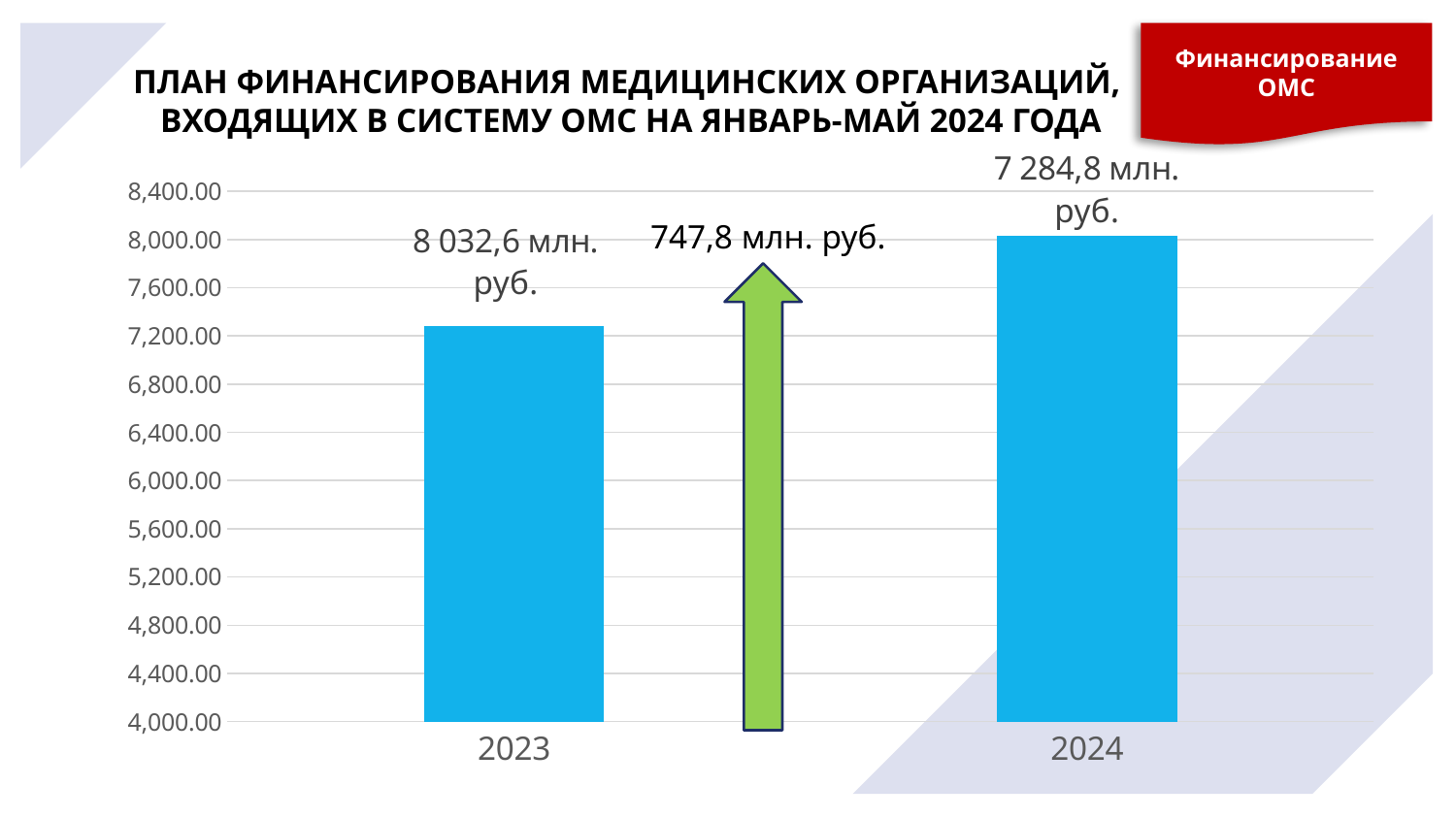
What difference between the two years is printed next to the green arrow? 747,8 млн. руб. How many bars are plotted in the chart? 2 What is the lowest value shown on the vertical axis? 4,000.00 Is the bar for 2024 greater or less than 7,600.00? greater What is the highest value shown on the vertical axis? 8,400.00 Is the bar for 2023 greater or less than 6,800.00? greater Which year has the shorter bar in the chart? 2023 Is the bar for 2023 greater or less than 7,600.00? less What kind of chart is shown on the slide? bar chart Do the bars rise or fall from 2023 to 2024? rise Which year has the taller bar in the chart? 2024